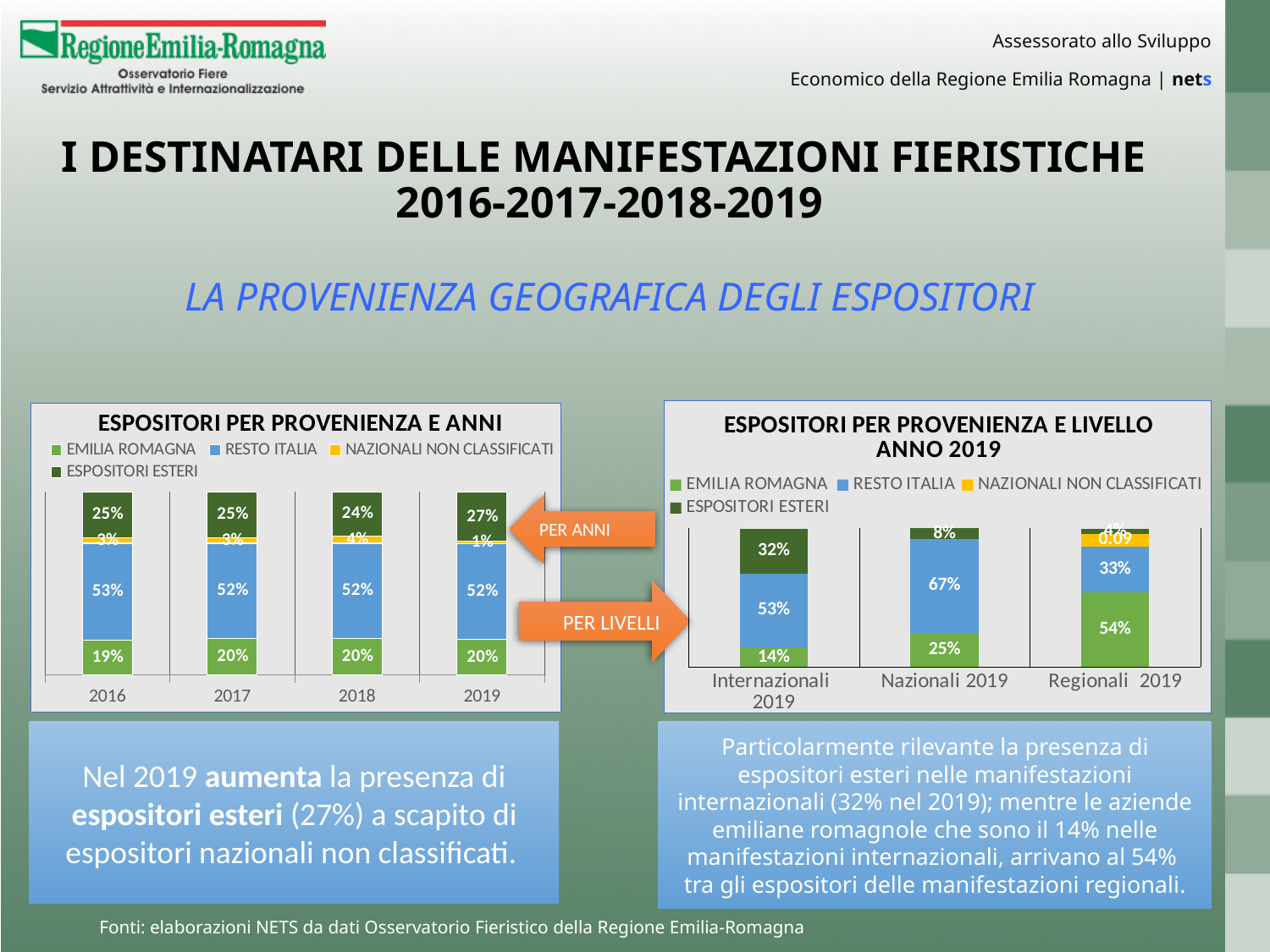
In the chart 'ESPOSITORI PER PROVENIENZA E ANNI', how many series does the legend list? 4 In the chart 'ESPOSITORI PER PROVENIENZA E LIVELLO ANNO 2019', what is the value for EMILIA ROMAGNA in Regionali 2019? 54% In the chart 'ESPOSITORI PER PROVENIENZA E ANNI', how many years are shown on the x axis? 4 In the chart 'ESPOSITORI PER PROVENIENZA E LIVELLO ANNO 2019', what is the value for ESPOSITORI ESTERI in Internazionali 2019? 32% In the chart 'ESPOSITORI PER PROVENIENZA E ANNI', what is the value for EMILIA ROMAGNA in 2016? 19% What kind of chart is 'ESPOSITORI PER PROVENIENZA E LIVELLO ANNO 2019'? Stacked bar chart In the chart 'ESPOSITORI PER PROVENIENZA E ANNI', what is the difference between the RESTO ITALIA value in 2016 and in 2019? 1% In the chart 'ESPOSITORI PER PROVENIENZA E LIVELLO ANNO 2019', is the EMILIA ROMAGNA value larger in Internazionali 2019 or in Nazionali 2019? Nazionali 2019 In the chart 'ESPOSITORI PER PROVENIENZA E ANNI', what is the value for RESTO ITALIA in 2017? 52% In the chart 'ESPOSITORI PER PROVENIENZA E LIVELLO ANNO 2019', which category has the highest RESTO ITALIA value? Nazionali 2019 In the chart 'ESPOSITORI PER PROVENIENZA E ANNI', in which year is the ESPOSITORI ESTERI value highest? 2019 In the chart 'ESPOSITORI PER PROVENIENZA E ANNI', what is the value for ESPOSITORI ESTERI in 2019? 27%